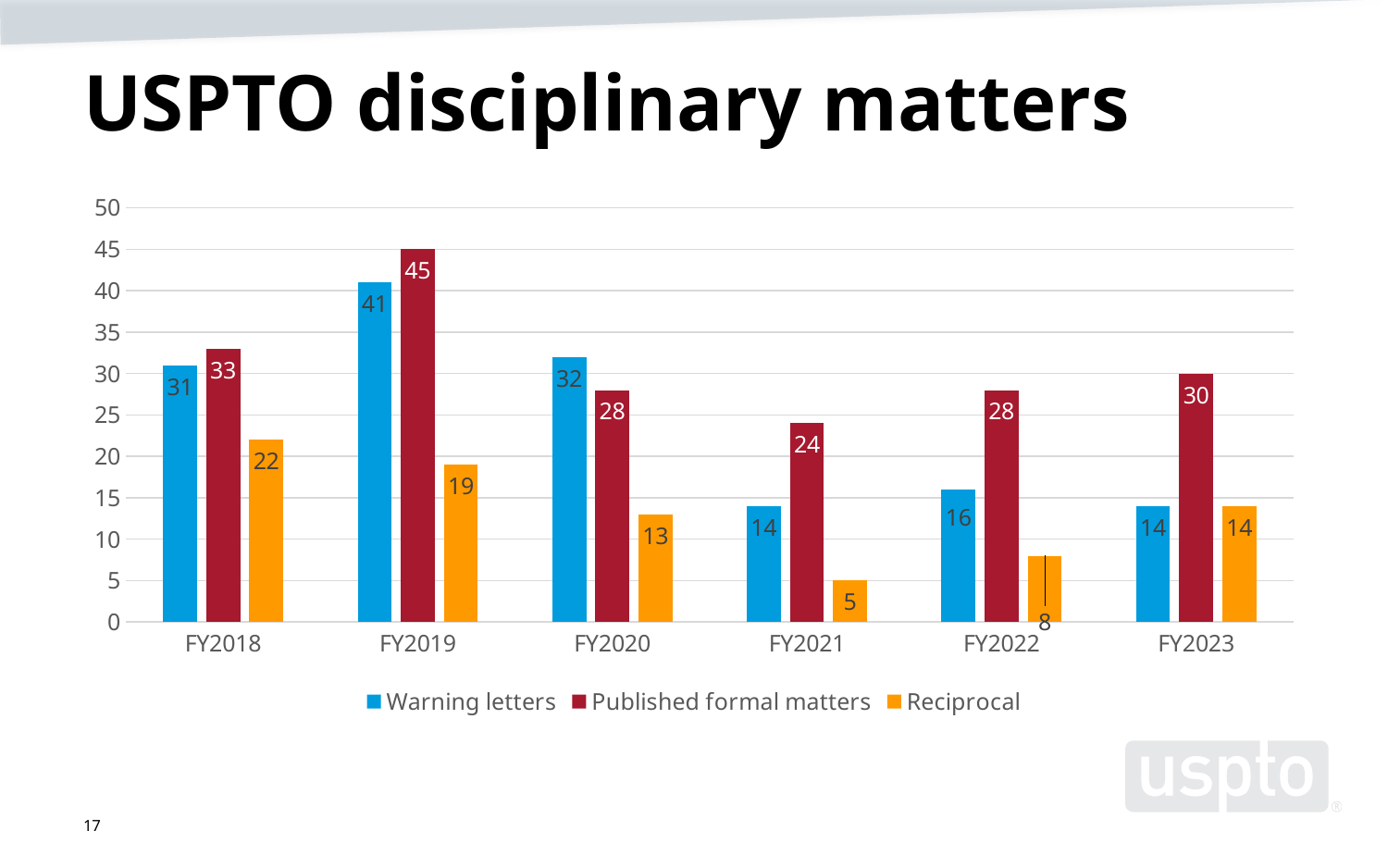
What is the title of the slide containing the chart? USPTO disciplinary matters What is the value for Warning letters in FY2019? 41 In which fiscal year is the Reciprocal value lowest? FY2021 What is the difference between Published formal matters and Warning letters in FY2021? 10 What is the value for Reciprocal in FY2021? 5 How many series does the legend list? 3 What is the value for Published formal matters in FY2023? 30 In which fiscal year is the Published formal matters value highest? FY2019 Is the value for Warning letters in FY2020 greater or less than 30? greater What kind of chart is shown on the slide? Bar chart How many fiscal years are shown on the x axis? 6 Which is larger in FY2018: Warning letters or Published formal matters? Published formal matters